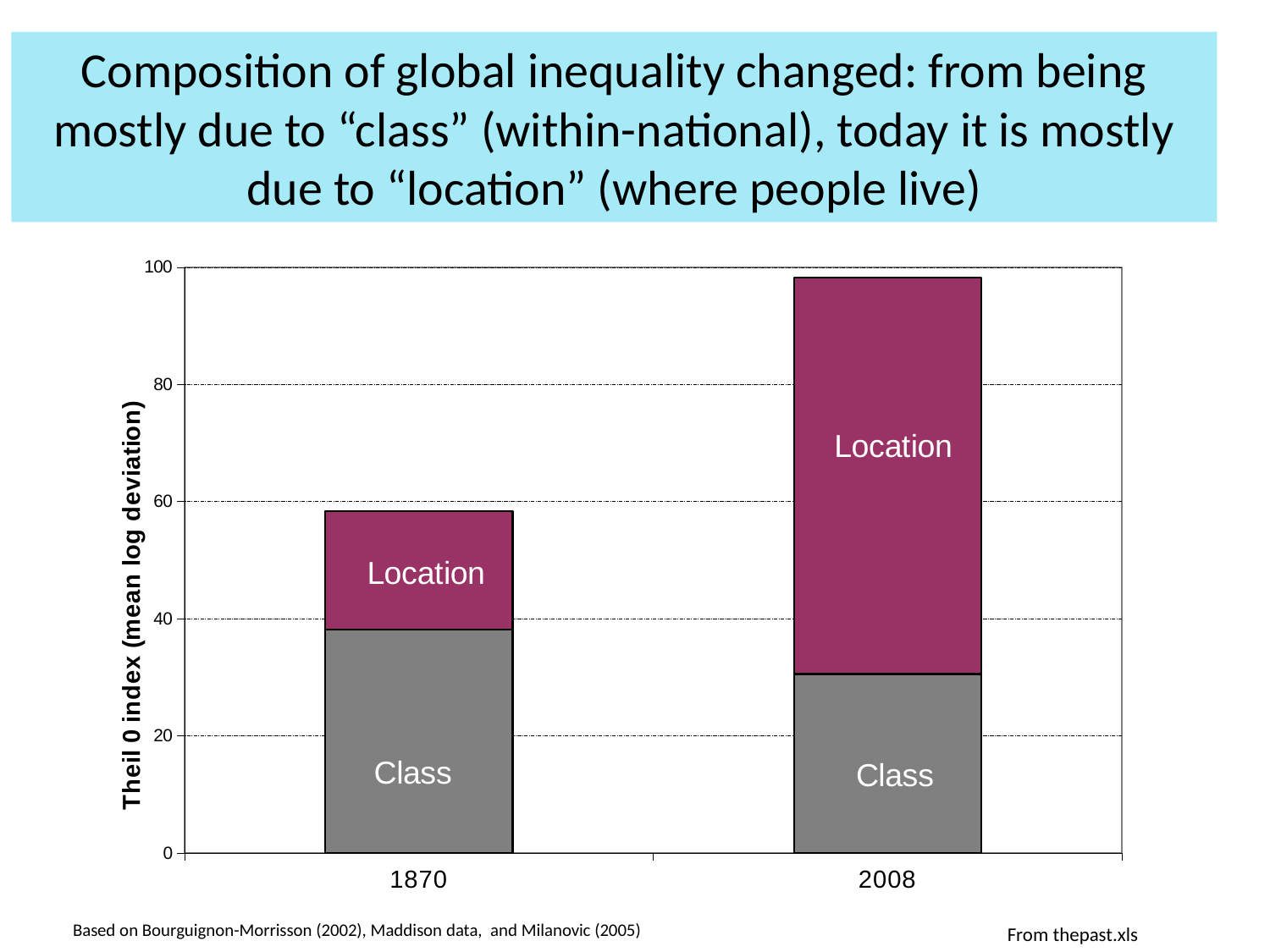
Is the Class component for 2008 greater or less than 40? less Which two years are shown on the x axis of the chart? 1870 and 2008 How many components are stacked in each bar of the chart? 2 Does the total Theil 0 index rise or fall from 1870 to 2008? rise How many years (categories) are shown on the x axis of the chart? 2 Is the total bar height for 1870 greater or less than 40? greater Is the Class component larger in 1870 or in 2008? 1870 What kind of chart is shown on the slide? Stacked bar chart What is the label of the y axis of the chart? Theil 0 index (mean log deviation) Is the Location component larger in 1870 or in 2008? 2008 Which year has the taller total bar, 1870 or 2008? 2008 Is the total bar height for 2008 greater or less than 80? greater